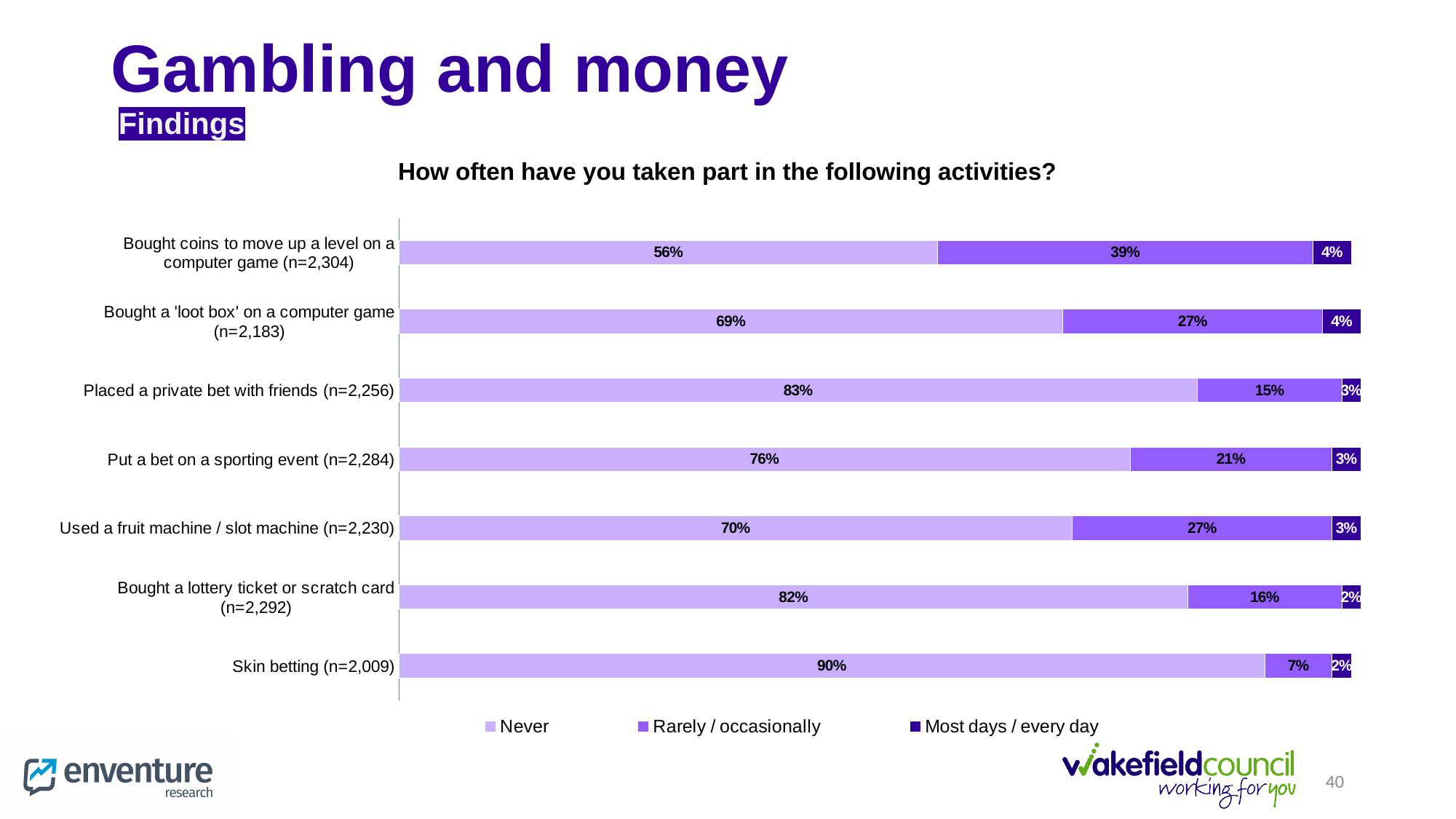
What is the title of the chart? How often have you taken part in the following activities? Which activity has the lowest 'Never' percentage? Bought coins to move up a level on a computer game (n=2,304) Which activity has the highest 'Never' percentage? Skin betting (n=2,009) What percentage of respondents said they took part in skin betting on 'Most days / every day'? 2% What percentage of respondents said they 'Rarely / occasionally' used a fruit machine / slot machine? 27% How many activities are shown in the chart? 7 What percentage of respondents said they 'Never' bought coins to move up a level on a computer game? 56% How many series does the legend list? 3 What kind of chart is shown on the slide? Stacked bar chart Which is larger: the 'Rarely / occasionally' percentage for 'Bought a loot box on a computer game' or for 'Put a bet on a sporting event'? Bought a 'loot box' on a computer game What is the difference between the 'Never' percentages for 'Placed a private bet with friends' and 'Put a bet on a sporting event'? 7% What is the total of the three segments for 'Bought a lottery ticket or scratch card'? 100%